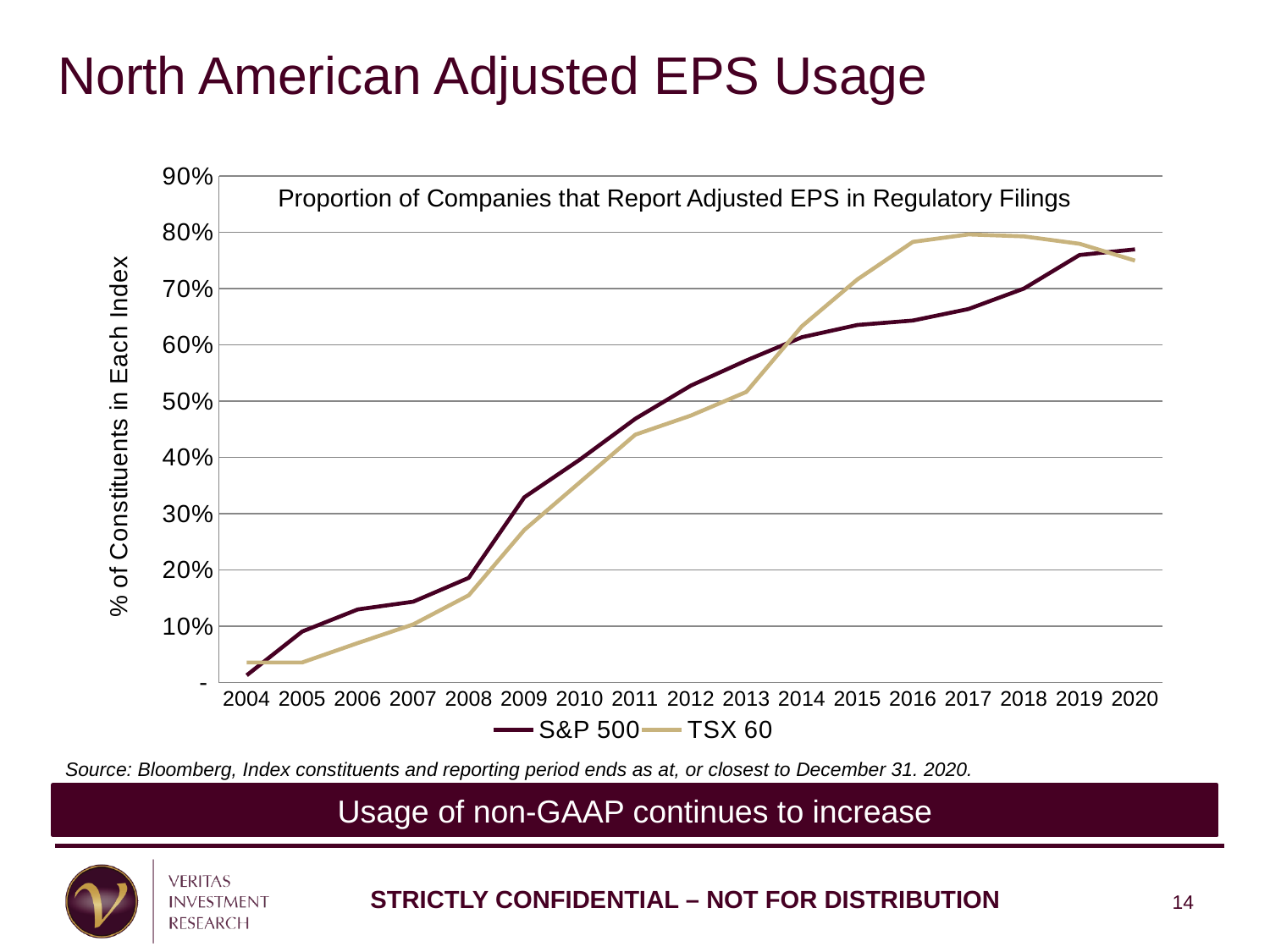
What kind of chart is shown on the slide? line chart How many series does the legend list? 2 What is the title printed inside the chart area? Proportion of Companies that Report Adjusted EPS in Regulatory Filings Is the TSX 60 value for 2016 greater or less than 70%? greater Does the S&P 500 line rise or fall from 2004 to 2020? rise In 2017, which series has the higher value, S&P 500 or TSX 60? TSX 60 Between 2017 and 2020, does the TSX 60 line rise or fall? fall How many years are shown on the x axis? 17 In 2012, which series has the higher value, S&P 500 or TSX 60? S&P 500 Is the S&P 500 value for 2010 greater or less than 30%? greater Is the TSX 60 value for 2005 greater or less than 10%? less